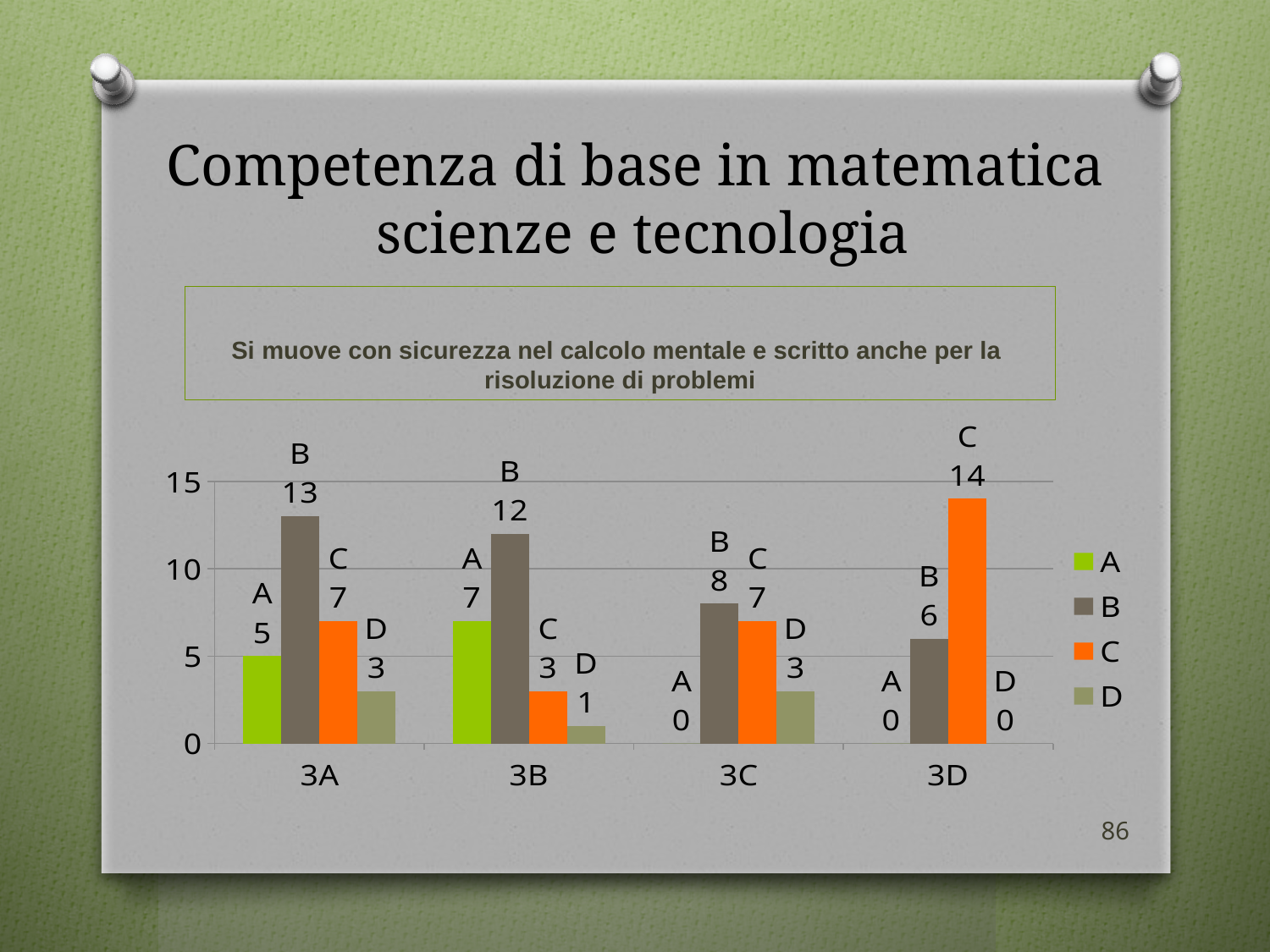
What is the value of series C for class 3D? 14 What is the value of series B for class 3A? 13 How many classes are shown on the x axis? 4 Which class has the lowest value for series C? 3B How many series does the legend list? 4 What is the value of series D for class 3B? 1 What colour represents series C in the legend? orange Which class has the highest value for series B? 3A What kind of chart is shown on the slide? bar chart What is the value of series A for class 3C? 0 What is the difference between series B and series A for class 3B? 5 Which is larger for class 3C: series B or series C? B